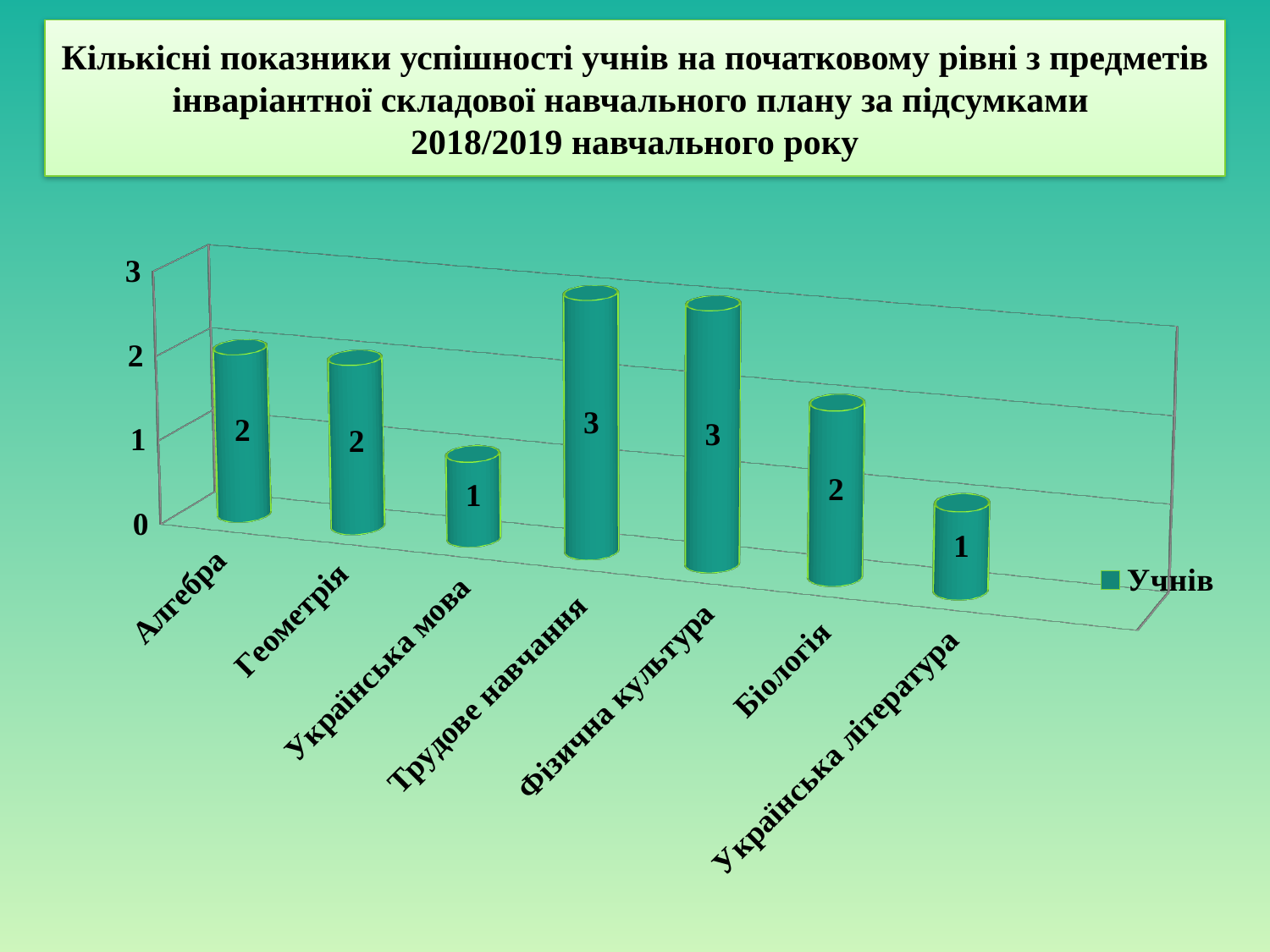
What is the value for Алгебра? 2 How many categories are shown on the x axis? 7 What is the value for Українська література? 1 Which two categories share the lowest value? Українська мова and Українська література What is the value for Трудове навчання? 3 How many series does the legend list? 1 What is the difference between the values for Фізична культура and Геометрія? 1 What is the value for Біологія? 2 Which two categories share the highest value? Трудове навчання and Фізична культура Which is larger, the value for Біологія or the value for Українська література? Біологія What kind of chart is shown on the slide? Bar chart What is the value for Українська мова? 1